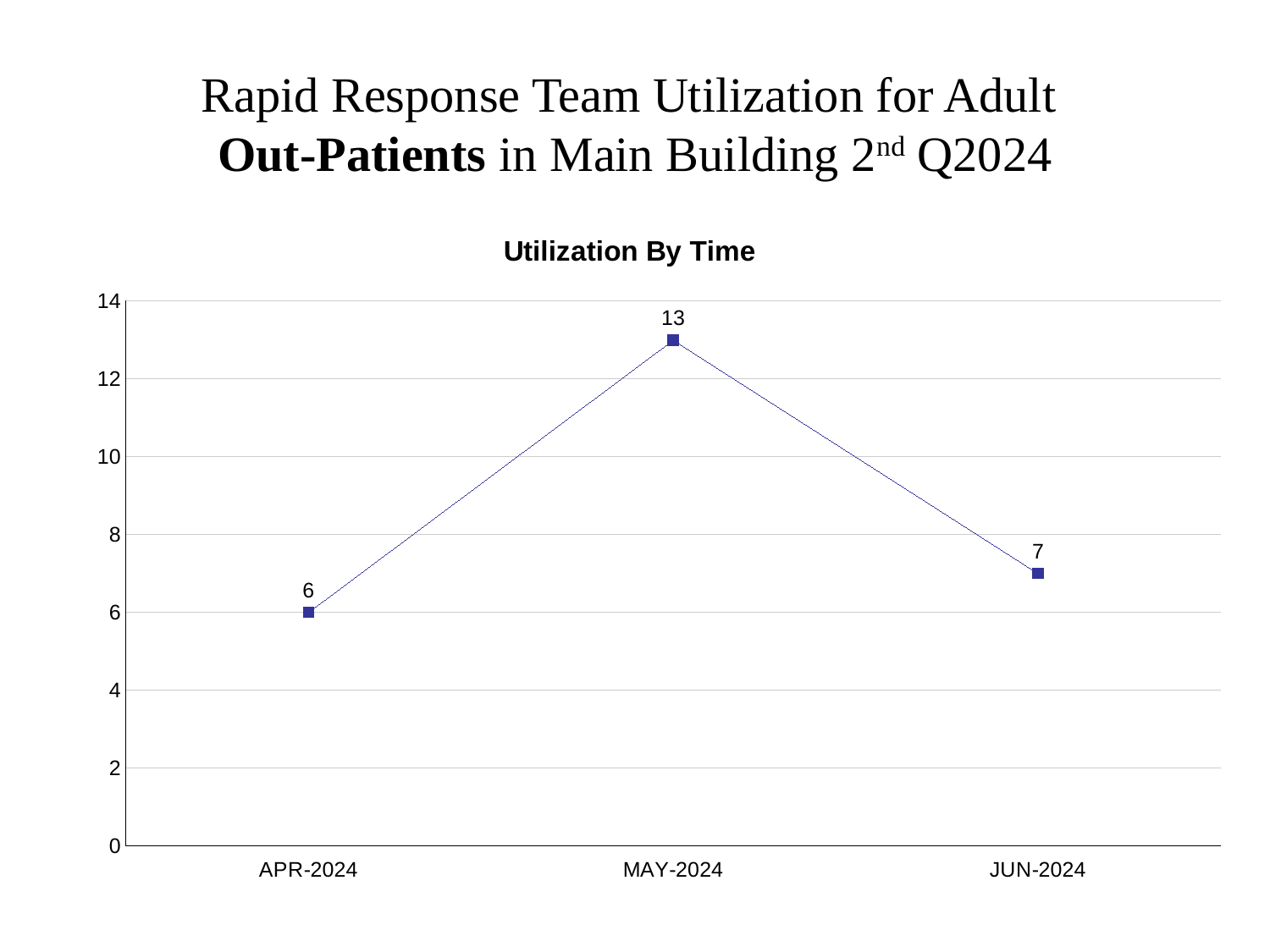
How many months are plotted on the chart? 3 What is the value for MAY-2024? 13 Is the value for MAY-2024 greater or less than 12? greater What is the difference between the values for MAY-2024 and JUN-2024? 6 Which month has the lowest value? APR-2024 What is the difference between the values for MAY-2024 and APR-2024? 7 Which month has the highest value? MAY-2024 Which is larger, the value for JUN-2024 or the value for APR-2024? JUN-2024 What is the value for APR-2024? 6 What is the title of the chart? Utilization By Time What kind of chart is shown? line chart What is the value for JUN-2024? 7